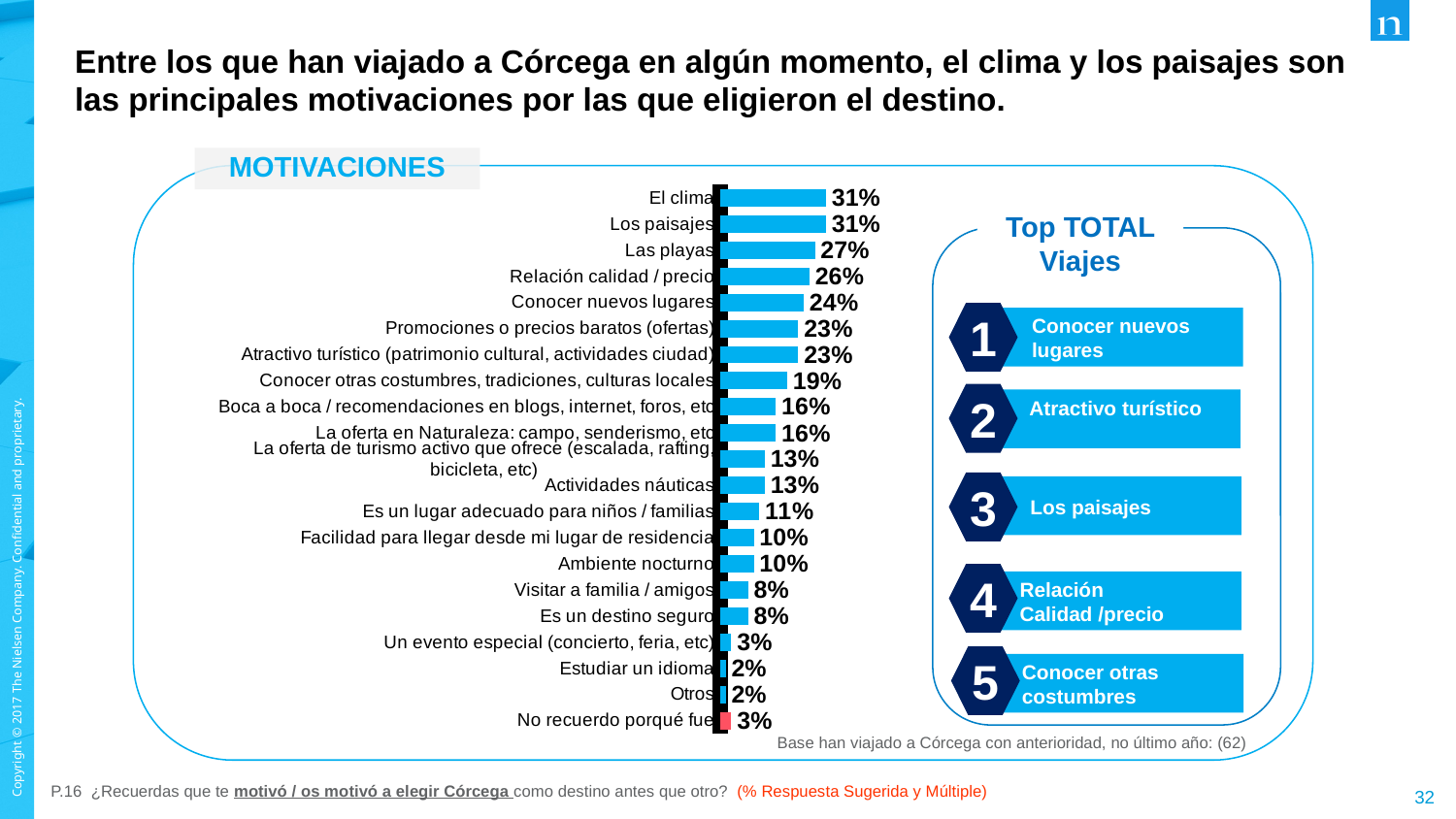
What type of chart is used to show the motivations? Bar chart Which has a higher value, "Actividades náuticas" or "Es un lugar adecuado para niños / familias"? Actividades náuticas What is the base size stated below the chart? 62 What percentage is shown for "Ambiente nocturno"? 10% What value is shown for "No recuerdo porqué fue"? 3% What percentage is shown for "Las playas" in the MOTIVACIONES chart? 27% What is the difference in percentage points between "Relación calidad / precio" and "Es un destino seguro"? 18 What is the highest percentage shown in the MOTIVACIONES chart? 31% How many categories are plotted in the MOTIVACIONES chart? 21 What is the difference in percentage points between "El clima" and "Las playas"? 4 What is the lowest percentage shown in the MOTIVACIONES chart? 2% What value does the chart show for "Conocer nuevos lugares"? 24%